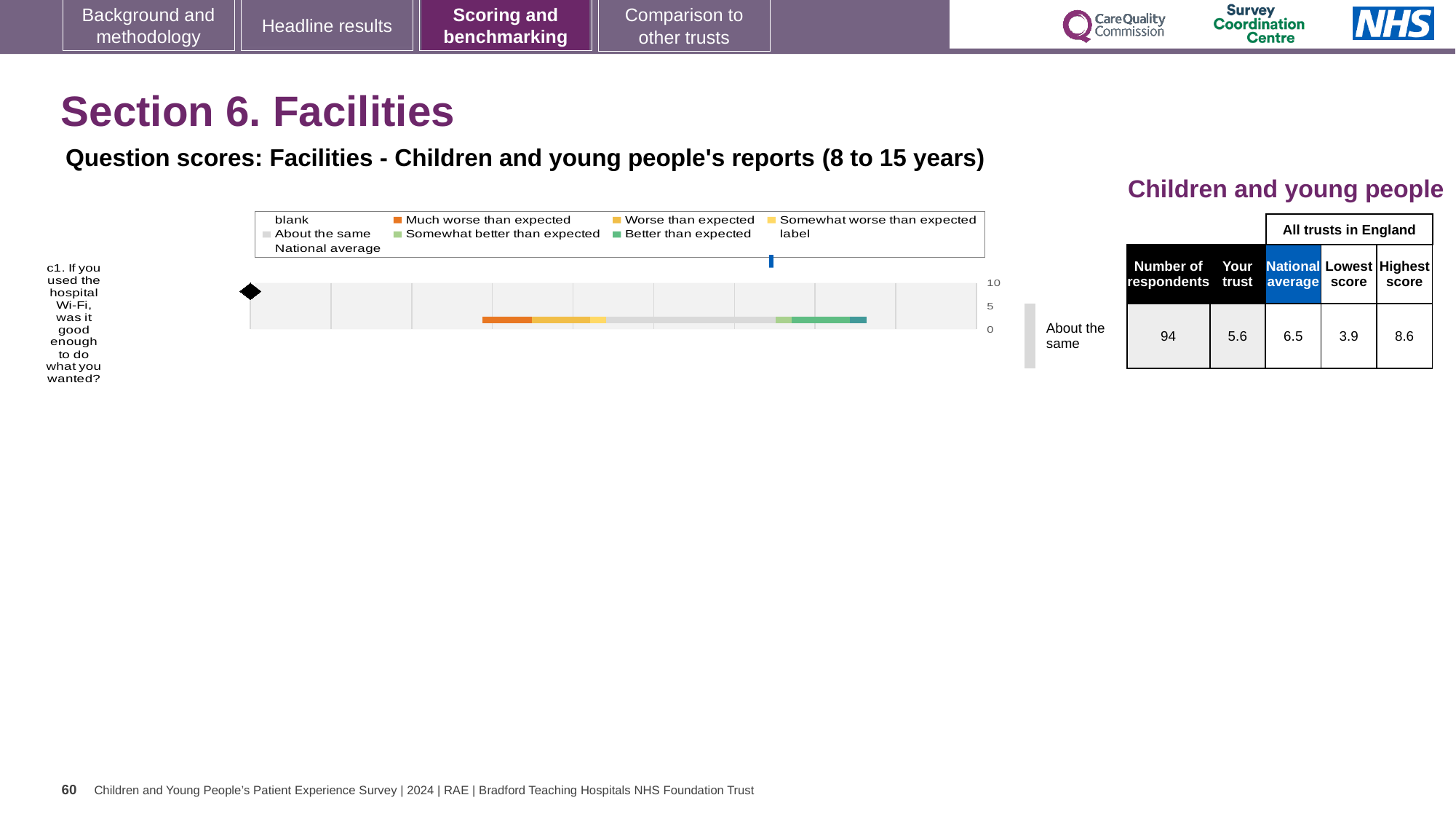
What is the trust's score for question c1 about the hospital Wi-Fi? 5.6 What is the difference between the national average and the trust's score for question c1? 0.9 What is the difference between the highest and lowest scores for question c1? 4.7 Which survey question is plotted in the chart? c1. If you used the hospital Wi-Fi, was it good enough to do what you wanted? What colour does the legend use for 'Much worse than expected'? Orange What is the lowest score among all trusts in England for question c1? 3.9 How many survey questions are plotted in the chart? 1 What kind of chart is shown on the slide? bar chart Which is larger for question c1: the trust's score or the national average? National average How many respondents answered question c1 about the hospital Wi-Fi? 94 What is the highest score among all trusts in England for question c1? 8.6 What is the national average score for question c1 about the hospital Wi-Fi? 6.5